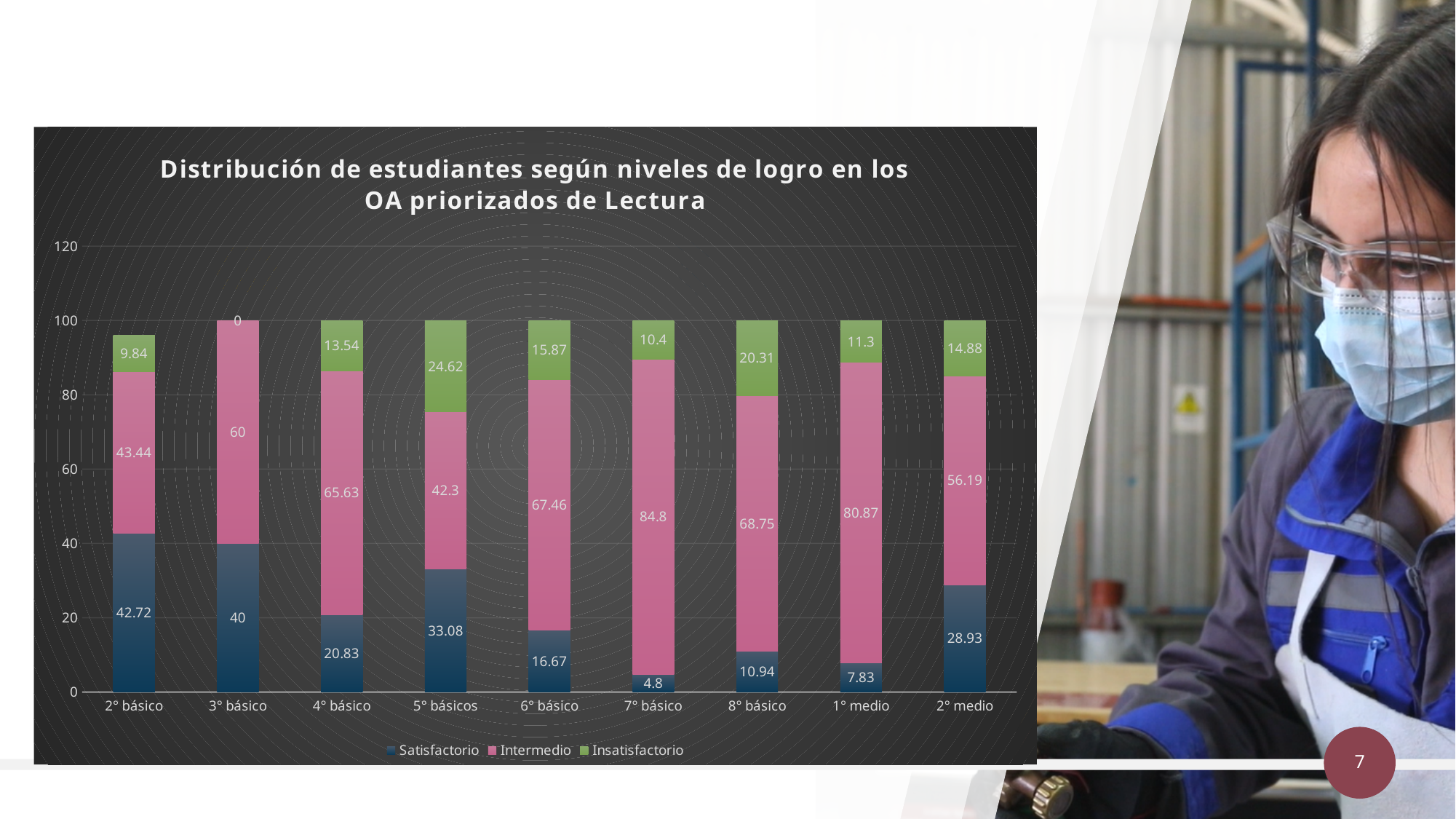
How many categories are shown on the x axis? 9 What is the Satisfactorio value for 2° básico? 42.72 What is the difference between the Satisfactorio values for 2° básico and 7° básico? 37.92 What kind of chart is shown? Stacked bar chart Which category has the highest Satisfactorio value? 2° básico How many series does the legend list? 3 What is the Insatisfactorio value for 5° básicos? 24.62 What is the total of the stacked bar for 2° básico? 96 Which category has the lowest Satisfactorio value? 7° básico Which category has the highest Intermedio value? 7° básico Which is larger, the Intermedio value for 1° medio or for 8° básico? 1° medio What is the Intermedio value for 7° básico? 84.8